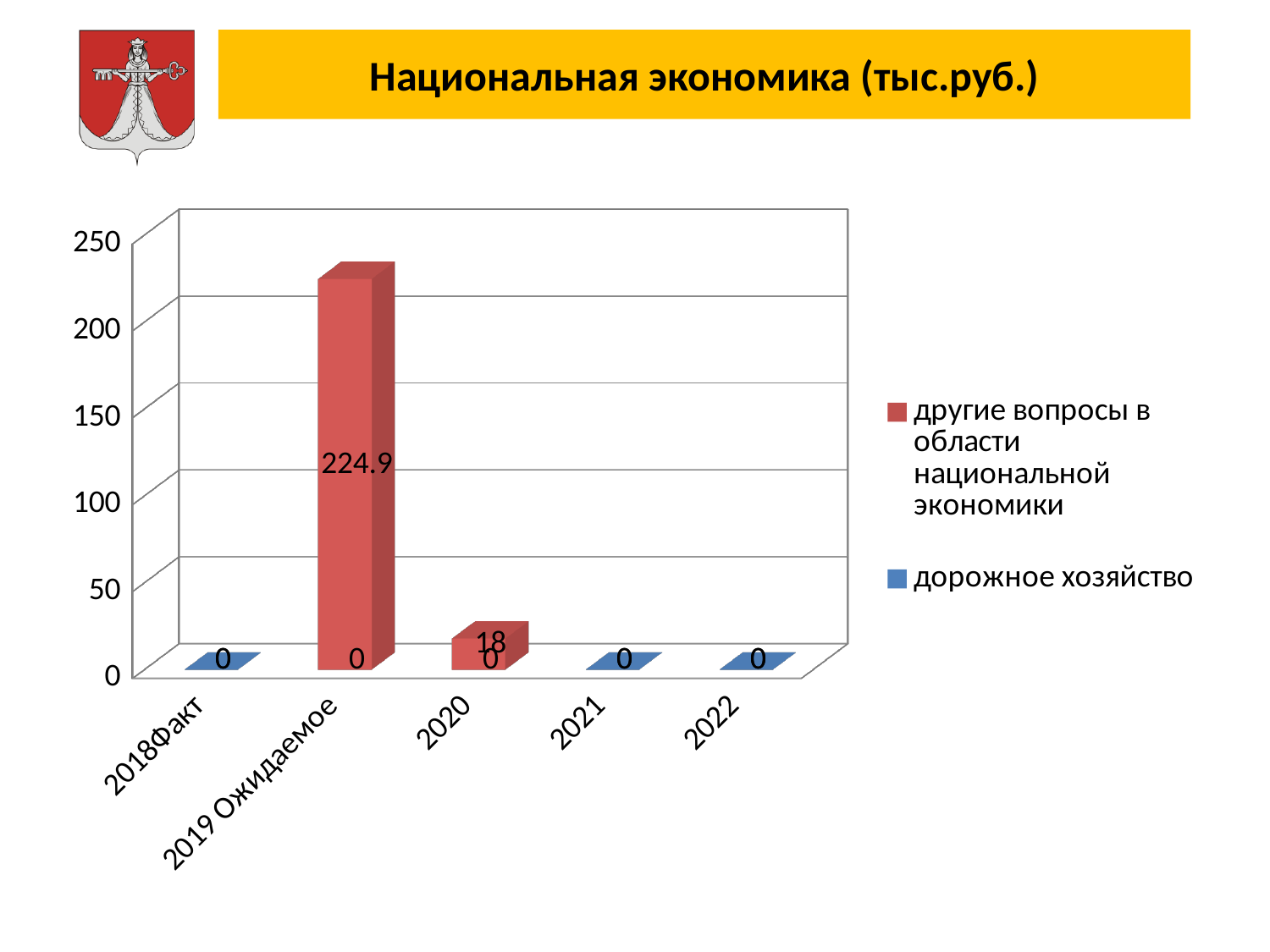
What is the title of the chart? Национальная экономика (тыс.руб.) What is the value for "другие вопросы в области национальной экономики" in 2019 Ожидаемое? 224.9 What is the value for "другие вопросы в области национальной экономики" in 2020? 18 Is the value for "другие вопросы в области национальной экономики" in 2019 Ожидаемое greater or less than 200? greater Which is larger for "другие вопросы в области национальной экономики": 2019 Ожидаемое or 2020? 2019 Ожидаемое Which category has the highest value for "другие вопросы в области национальной экономики"? 2019 Ожидаемое What is the value for "дорожное хозяйство" in 2019 Ожидаемое? 0 How many series does the legend list? 2 Is the value for "другие вопросы в области национальной экономики" in 2020 greater or less than 50? less What is the difference between the "другие вопросы в области национальной экономики" values for 2019 Ожидаемое and 2020? 206.9 How many categories are shown on the x axis? 5 What kind of chart is shown on the slide? bar chart